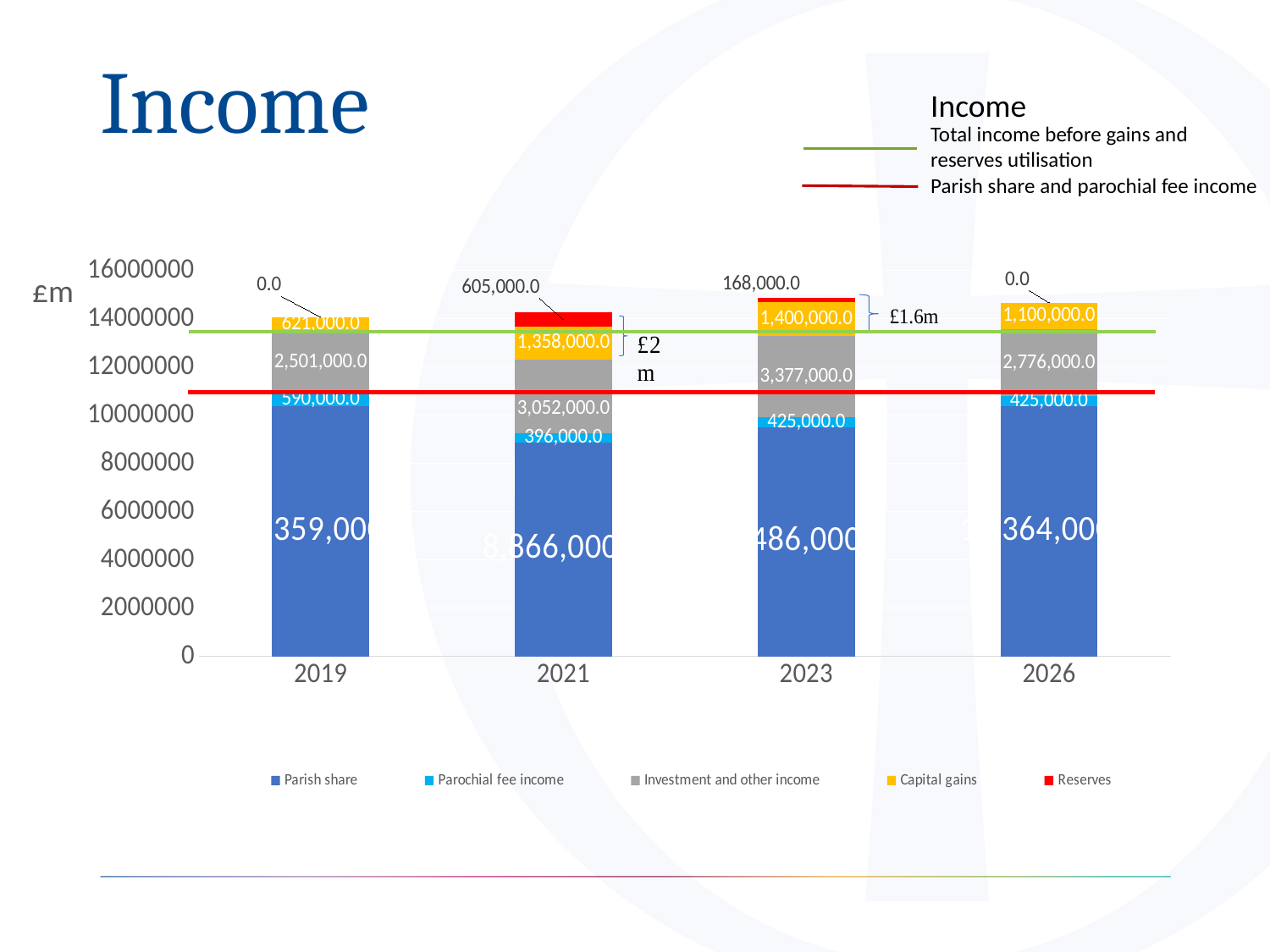
Which year has the larger Parochial fee income, 2019 or 2021? 2019 What is the difference between Capital gains in 2023 and Capital gains in 2026? 300,000.0 What is the value of Reserves for 2021? 605,000.0 How many series does the legend of the bar chart list? 5 What is the value of Capital gains for 2021? 1,358,000.0 What is the value of Reserves for 2023? 168,000.0 How many years are shown on the x axis of the chart? 4 Which year has the highest value for Investment and other income? 2023 Which year has the lowest value for Capital gains? 2019 What is the value of Investment and other income for 2023? 3,377,000.0 What kind of chart is shown on the slide? Stacked bar chart What does the green horizontal line on the chart represent? Total income before gains and reserves utilisation